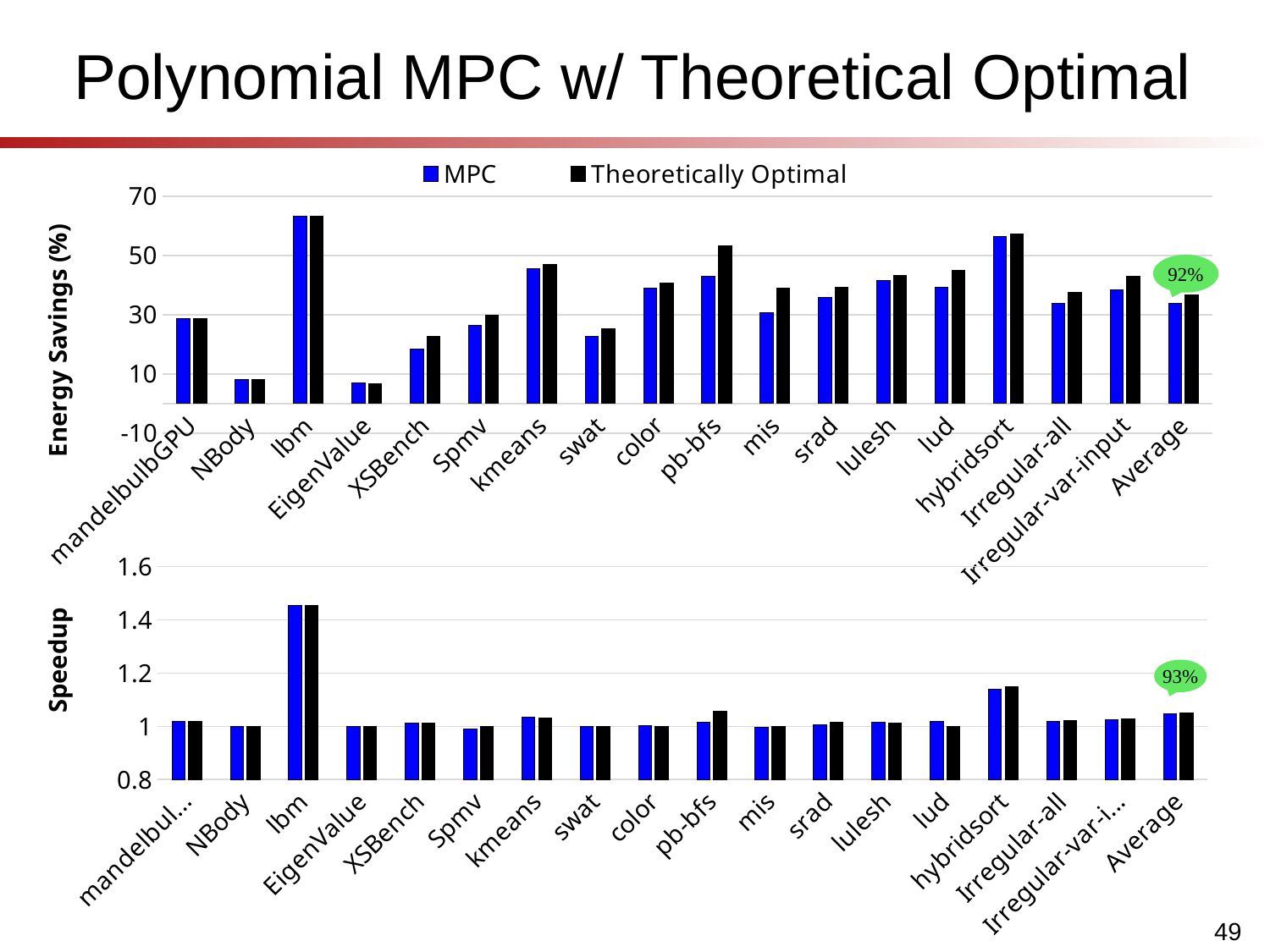
How many categories are shown on the x axis of the Speedup chart? 18 In the Speedup chart, which category has the highest speedup? lbm In the Energy Savings chart, what percentage is shown in the callout next to the Average bars? 92% In the Speedup chart, is the MPC value for lbm greater or less than 1.4? greater In the Energy Savings chart, is the MPC value for NBody greater or less than 10? less In the Energy Savings chart, is the MPC value for lbm greater or less than 50? greater What kind of chart is the top chart (Energy Savings)? bar chart How many series does the legend list for the charts? 2 In the Speedup chart, what percentage is shown in the callout next to the Average bars? 93% In the Energy Savings chart, which category has the highest MPC energy savings? lbm In the Energy Savings chart, which has the larger MPC energy savings: kmeans or swat? kmeans In the Energy Savings chart, which is larger for pb-bfs: the MPC value or the Theoretically Optimal value? Theoretically Optimal